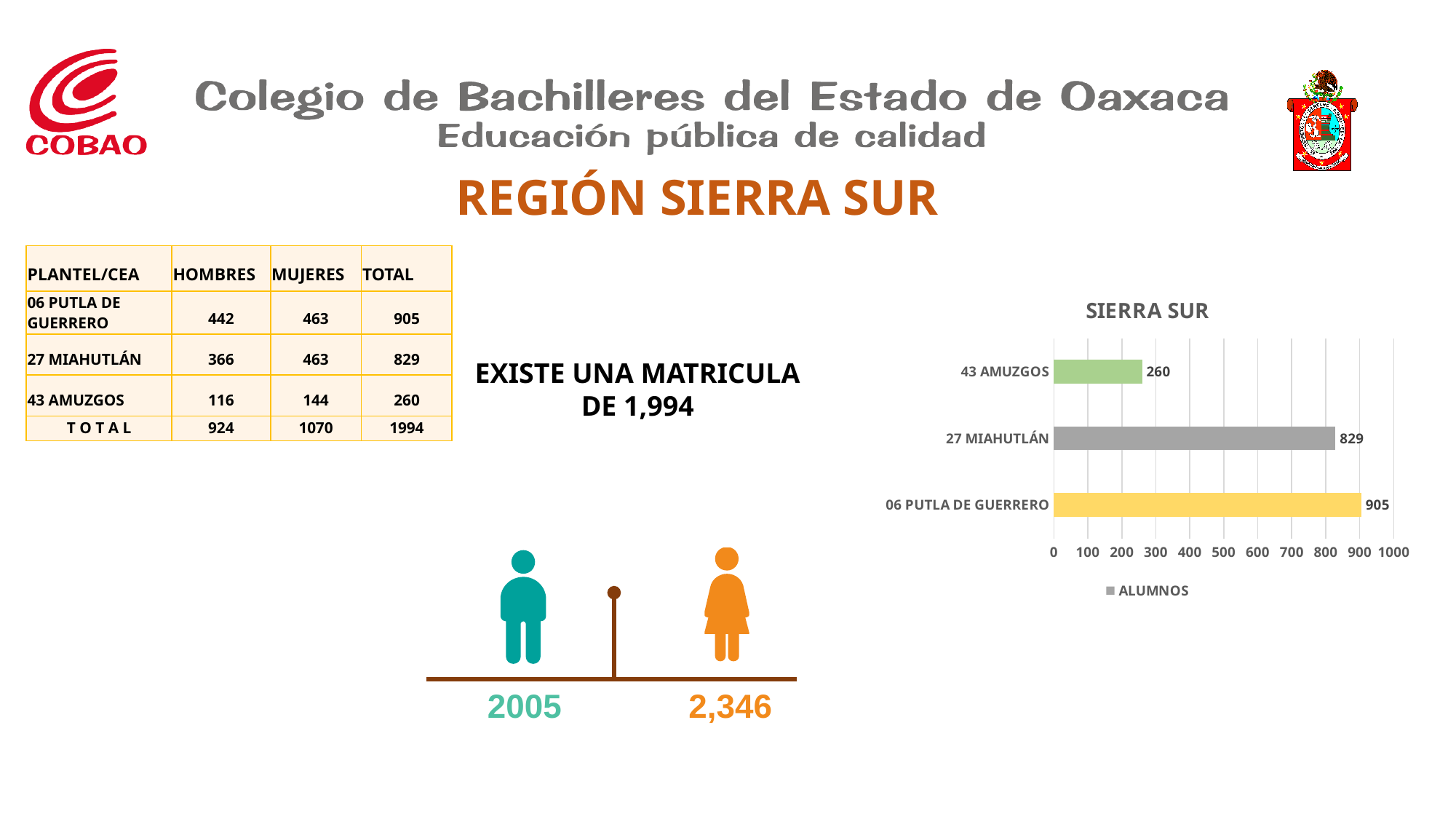
What series name does the legend of the SIERRA SUR chart show? ALUMNOS What kind of chart is the SIERRA SUR chart? Bar chart What is the value for 27 MIAHUTLÁN in the SIERRA SUR chart? 829 Which category has the highest value in the SIERRA SUR chart? 06 PUTLA DE GUERRERO What is the value for 43 AMUZGOS in the SIERRA SUR chart? 260 What is the difference between the values for 06 PUTLA DE GUERRERO and 27 MIAHUTLÁN in the SIERRA SUR chart? 76 Which is larger in the SIERRA SUR chart, the value for 43 AMUZGOS or the value for 27 MIAHUTLÁN? 27 MIAHUTLÁN How many categories are shown in the SIERRA SUR chart? 3 Which category has the lowest value in the SIERRA SUR chart? 43 AMUZGOS What is the difference between the values for 27 MIAHUTLÁN and 43 AMUZGOS in the SIERRA SUR chart? 569 Is the value for 27 MIAHUTLÁN in the SIERRA SUR chart greater or less than 700? greater What is the value for 06 PUTLA DE GUERRERO in the SIERRA SUR chart? 905